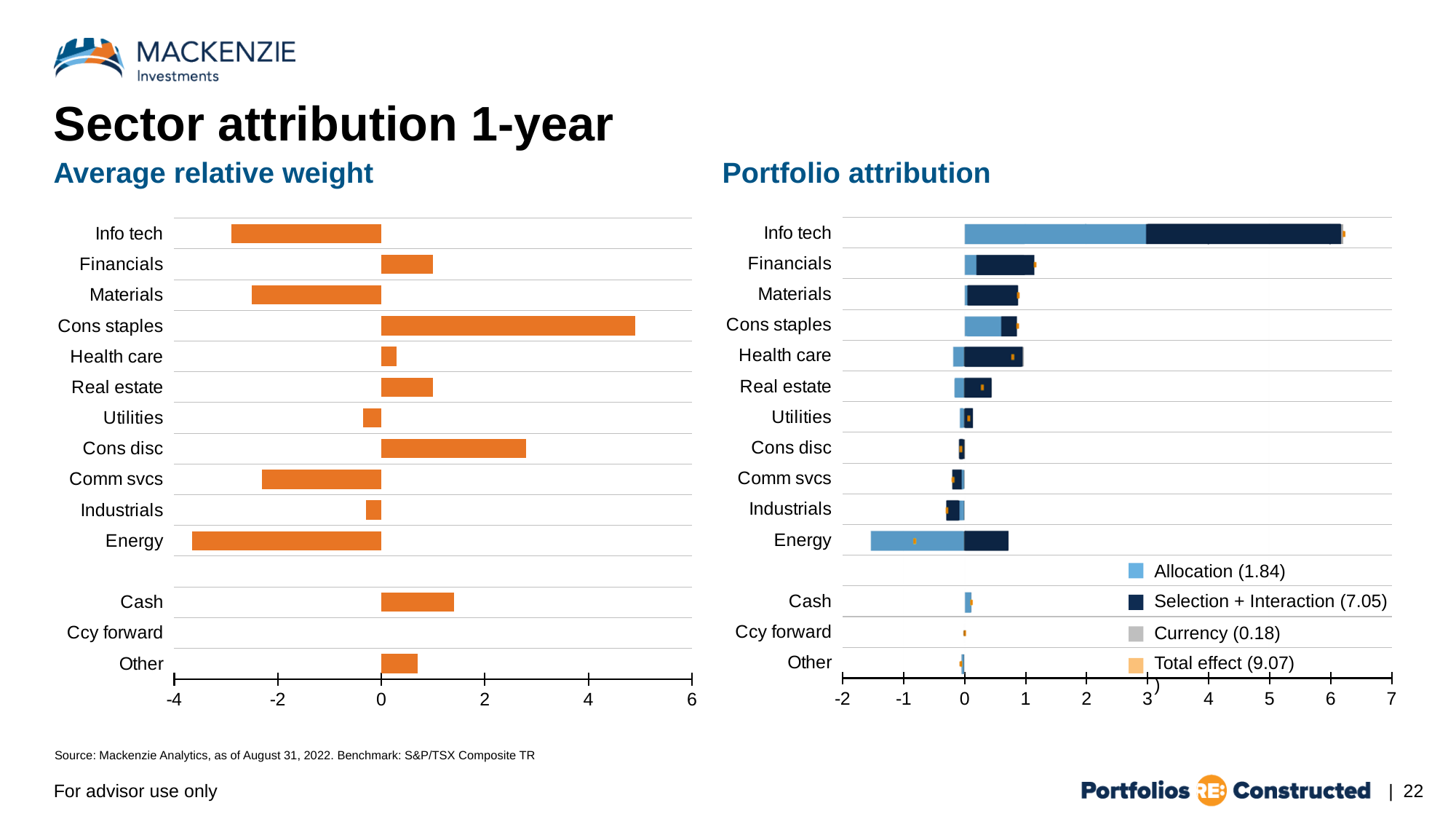
In the "Average relative weight" chart, which category has the lowest relative weight? Energy How many series does the legend of the "Portfolio attribution" chart list? 4 In the "Average relative weight" chart, is the value for Cons disc greater or less than 2? greater In the "Average relative weight" chart, is the value for Energy greater or less than -2? less In the "Portfolio attribution" chart, which category has the largest total bar? Info tech In the "Portfolio attribution" chart, is the Allocation value for Energy greater or less than -1? less How many categories are shown in the "Average relative weight" chart? 14 In the "Average relative weight" chart, which category has the highest relative weight? Cons staples In the "Portfolio attribution" chart legend, what value is shown for Total effect? 9.07 In the "Average relative weight" chart, which is larger, the value for Cons staples or the value for Cons disc? Cons staples What kind of chart is the "Average relative weight" chart? bar chart